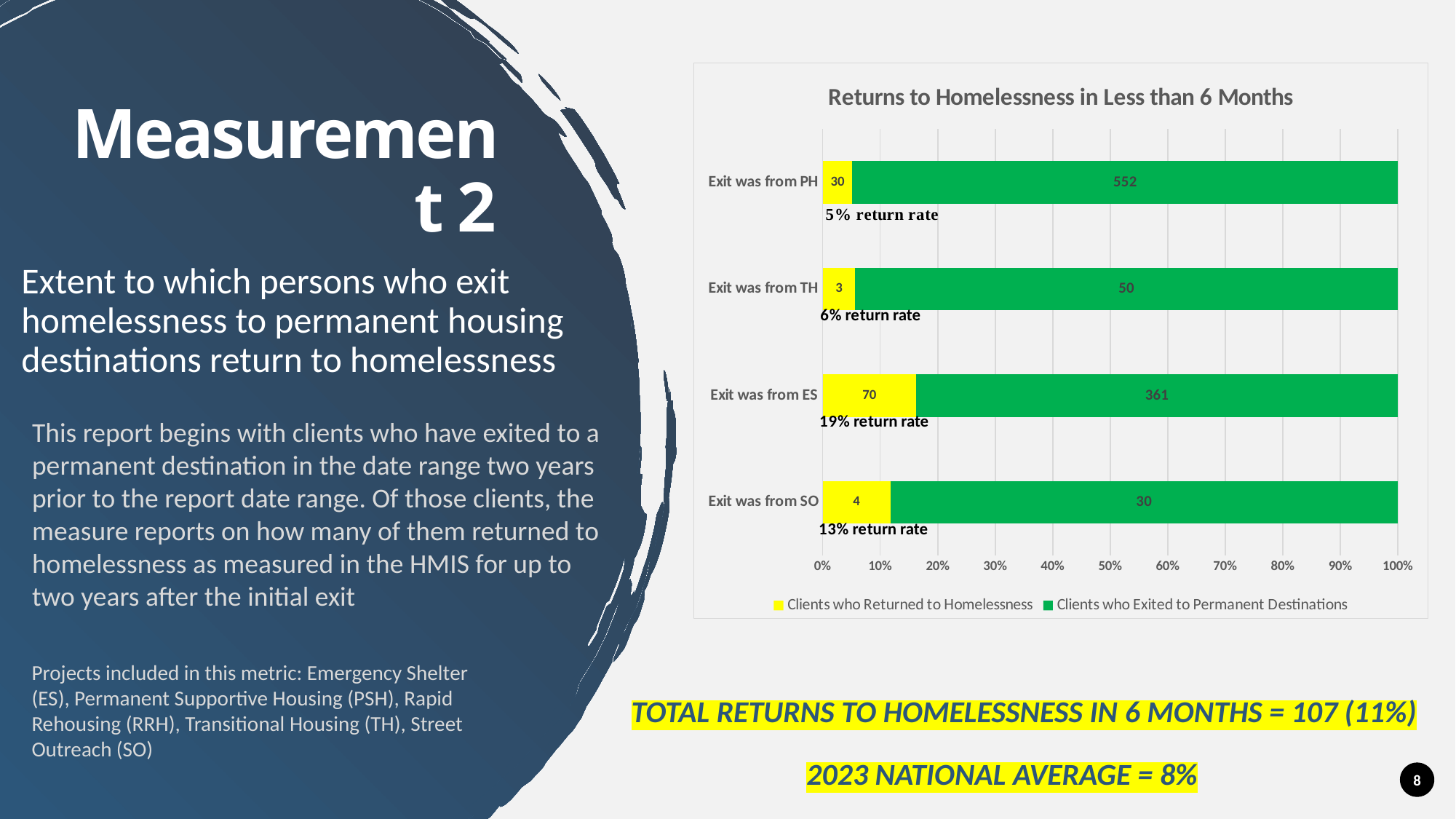
Which exit category has the lowest number of clients who exited to permanent destinations? Exit was from SO Which exit category has the highest number of clients who returned to homelessness? Exit was from ES What is the difference between the number of clients who exited to permanent destinations from PH and from ES? 191 How many exit categories are plotted in the chart? 4 How many clients who exited from TH returned to homelessness? 3 Which is larger: the number of clients who returned to homelessness from SO or from TH? Exit was from SO How many series does the chart legend list? 2 What is the title of the chart? Returns to Homelessness in Less than 6 Months What kind of chart is shown on the slide? Bar chart What return rate is shown for clients who exited from ES? 19% return rate How many clients who exited from ES exited to permanent destinations? 361 How many clients who exited from PH returned to homelessness? 30